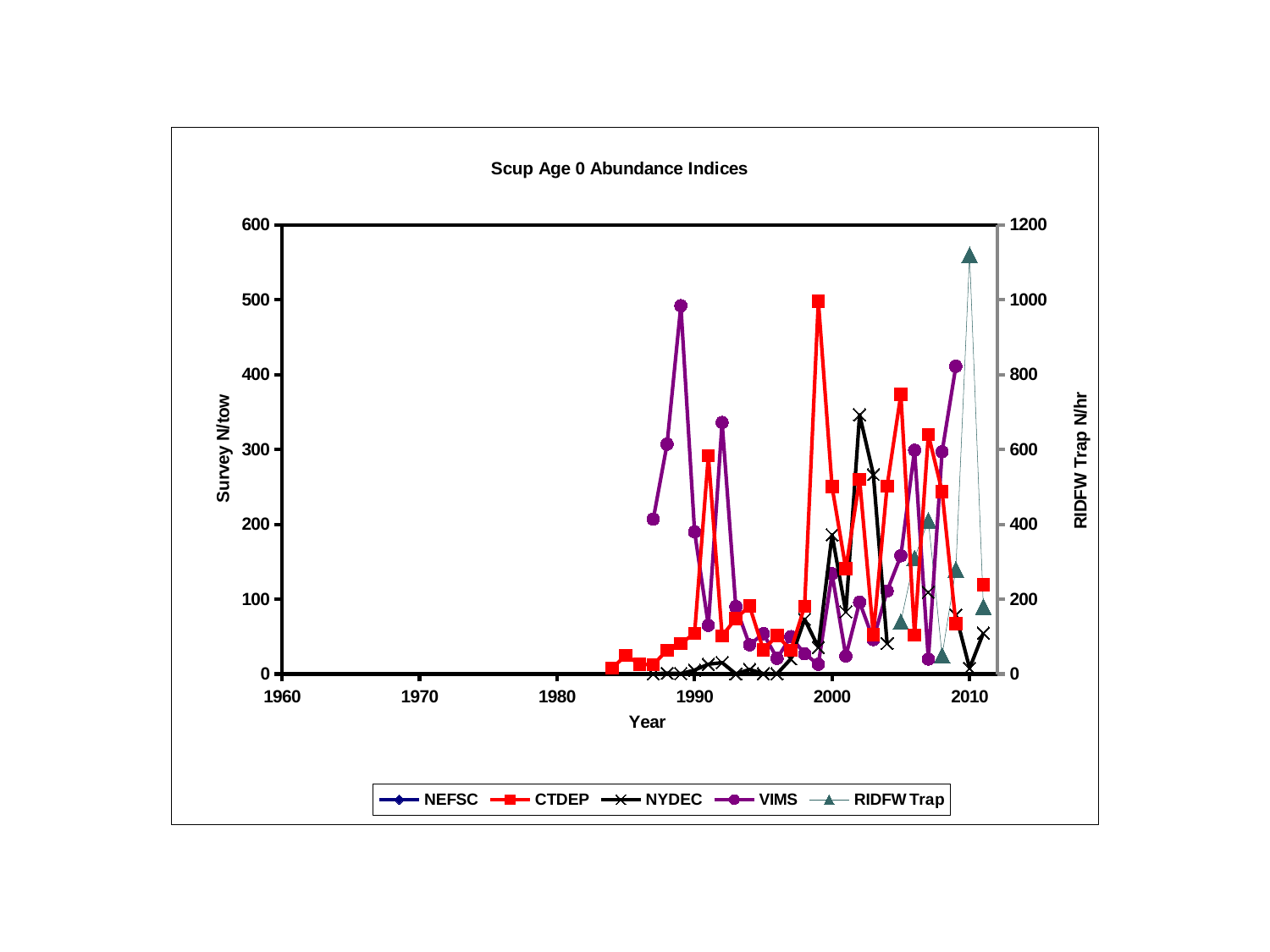
Is the CTDEP value in 1999 greater or less than 400? greater What is the label of the right-hand vertical axis? RIDFW Trap N/hr Which is larger, the VIMS value in 1989 or the VIMS value in 1992? 1989 How many series does the legend list? 5 Is the CTDEP value in 1985 greater or less than 100? less In which year does the RIDFW Trap series reach its highest value? 2010 What kind of chart is shown on the slide? Line chart Is the RIDFW Trap value in 2010 greater or less than 1000 on the right-hand axis? greater What is the title of the chart? Scup Age 0 Abundance Indices In which year does the VIMS series reach its highest value? 1989 In which year does the CTDEP series reach its highest value? 1999